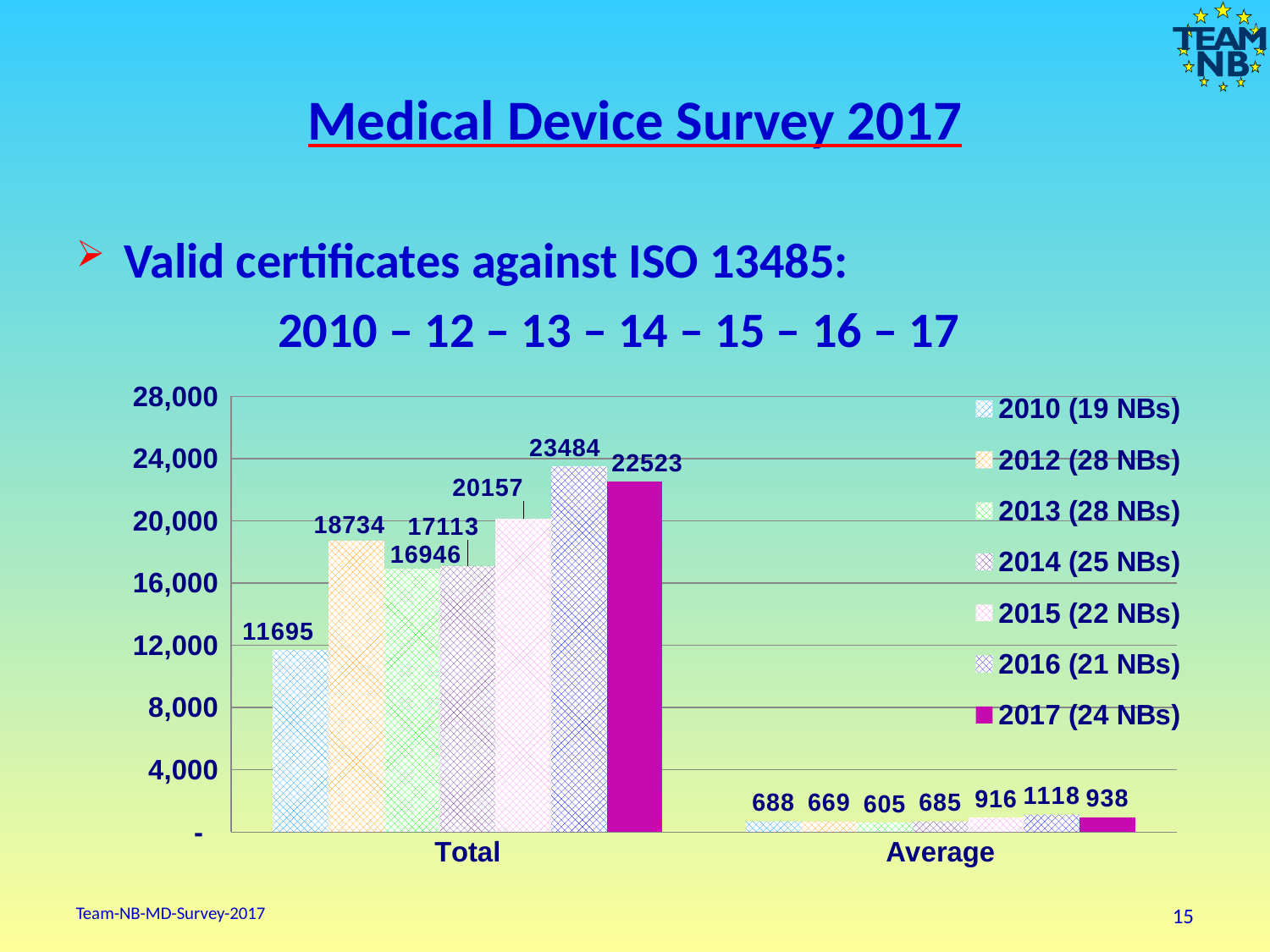
Which is larger, the Total value for 2012 (28 NBs) or for 2013 (28 NBs)? 2012 (28 NBs) Which year has the lowest Average value? 2013 (28 NBs) What is the Total value for 2010 (19 NBs)? 11695 What is the Total value for 2017 (24 NBs)? 22523 How many series does the legend list? 7 How many categories are shown on the x axis? 2 Which year has the highest Total value? 2016 (21 NBs) What kind of chart is shown on the slide? bar chart What is the Average value for 2016 (21 NBs)? 1118 Which series is drawn as a solid magenta bar? 2017 (24 NBs) Is the Total value for 2015 (22 NBs) greater or less than 20,000? greater What is the difference between the Total values for 2016 (21 NBs) and 2017 (24 NBs)? 961